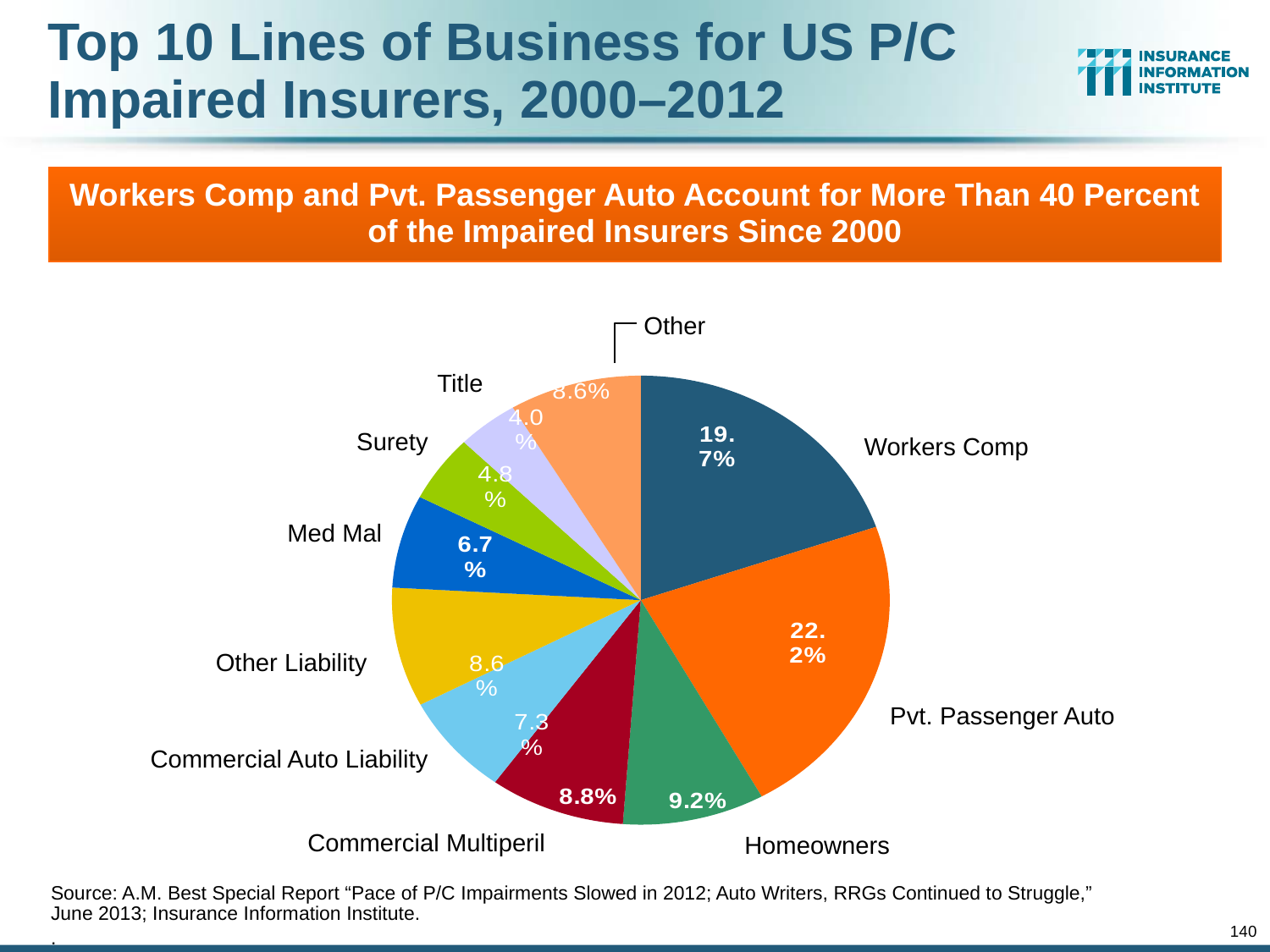
What is the combined share of Workers Comp and Pvt. Passenger Auto? 41.9% What share of impaired insurers is attributed to Workers Comp? 19.7% What percentage is shown for Commercial Auto Liability? 7.3% What share of impaired insurers is attributed to Pvt. Passenger Auto? 22.2% Which is larger, the share for Homeowners or the share for Commercial Multiperil? Homeowners How many lines of business (slices) are shown in the pie chart? 10 Which line of business has the smallest slice of the pie? Title What is the difference in percentage points between Pvt. Passenger Auto and Workers Comp? 2.5 What percentage is shown for Homeowners? 9.2% What kind of chart is shown on the slide? Pie chart What percentage is shown for Med Mal? 6.7% Which line of business has the largest slice of the pie? Pvt. Passenger Auto